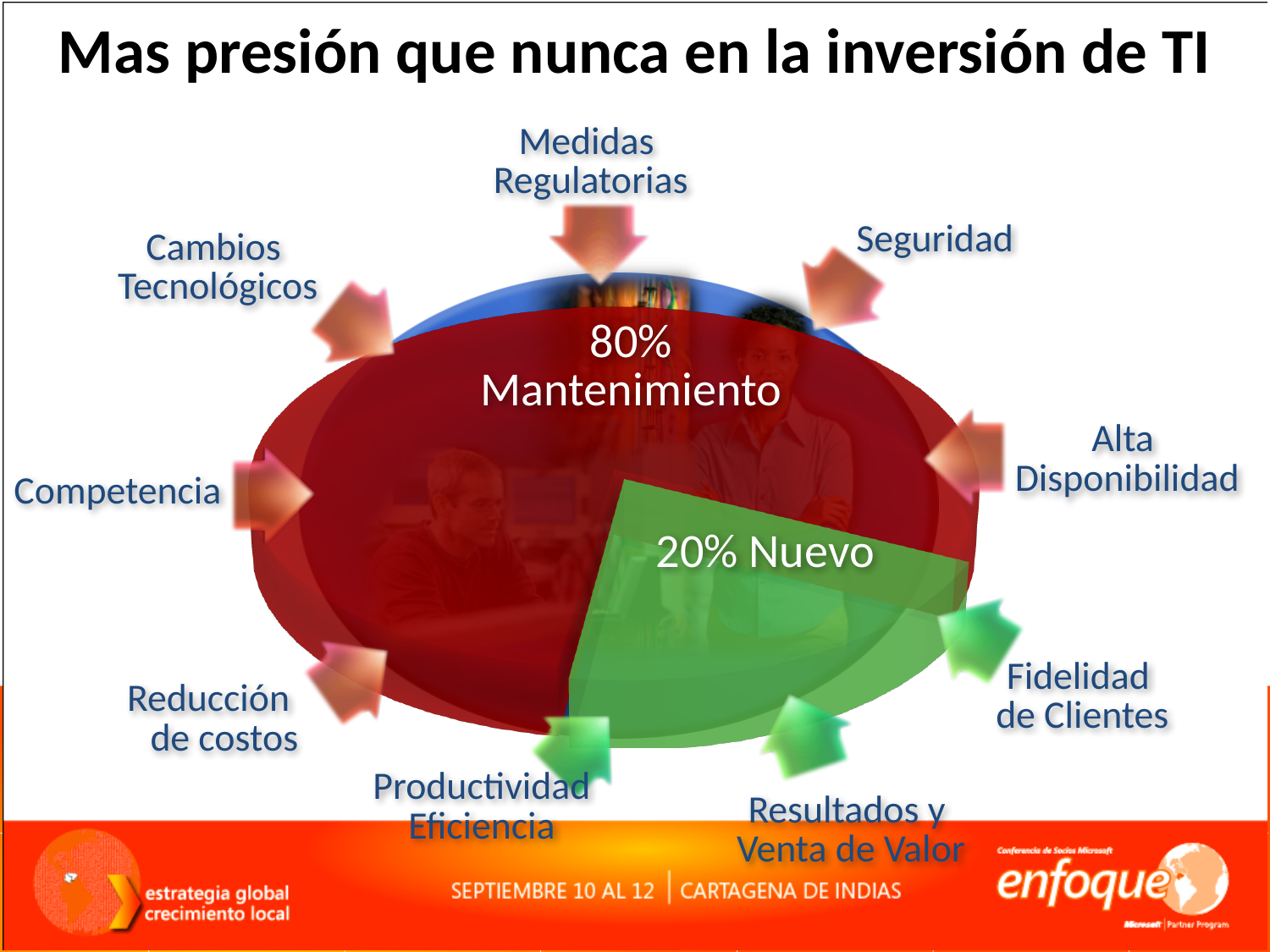
What share of the pie is labelled Mantenimiento? 80% How many slices does the pie chart have? 2 What is the difference in percentage points between the Mantenimiento slice and the Nuevo slice? 60 Which slice of the pie is the smallest? Nuevo Which is larger, the Mantenimiento slice or the Nuevo slice? Mantenimiento What colour is the Mantenimiento slice of the pie? Red What is the combined share of the Mantenimiento and Nuevo slices? 100% What kind of chart is shown on the slide? Pie chart What share of the pie is labelled Nuevo? 20% What colour is the Nuevo slice of the pie? Green Which slice of the pie is the largest? Mantenimiento